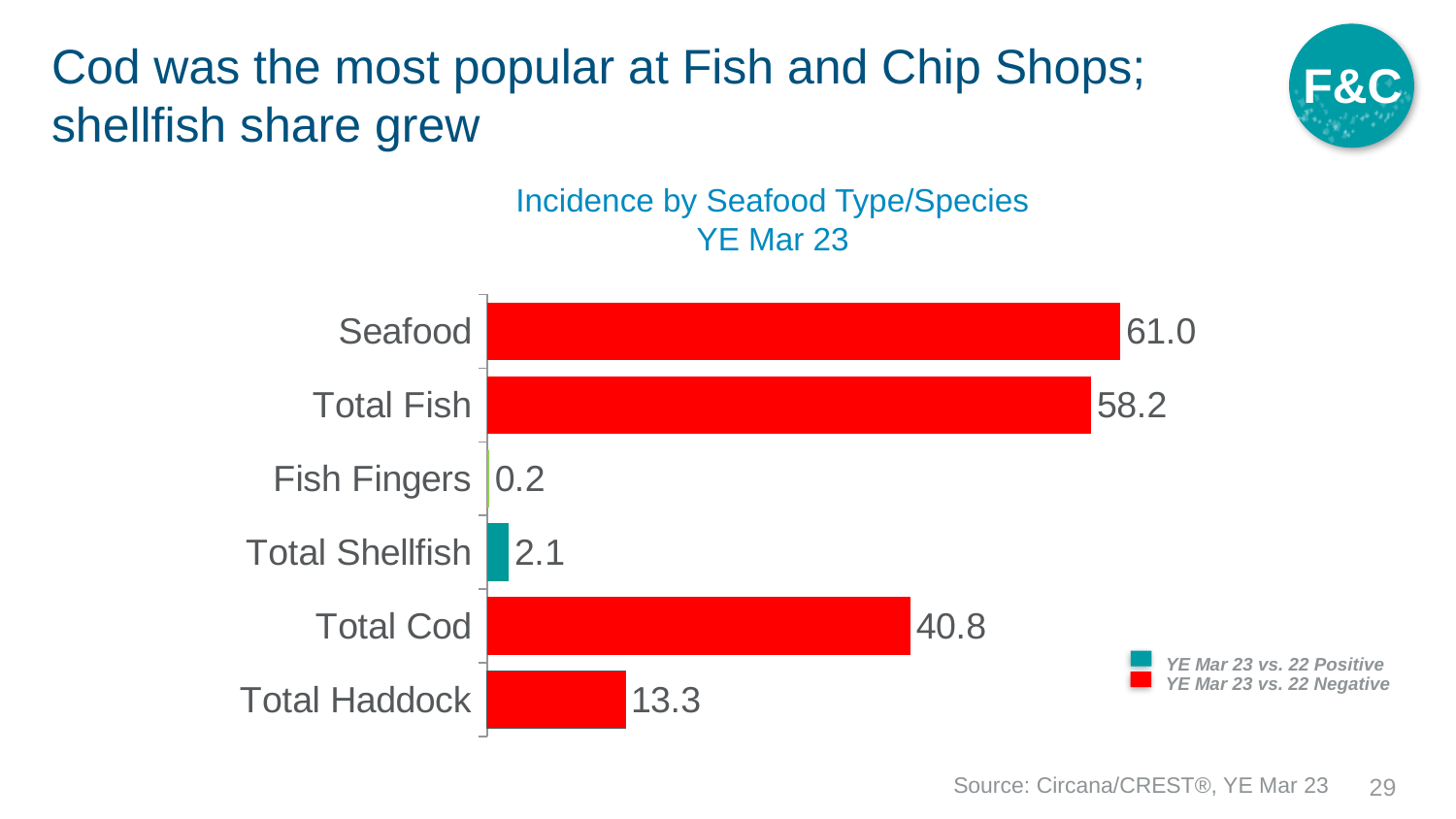
Which category has the highest value? Seafood What is the value for Total Cod? 40.8 What is the value for Seafood? 61.0 What is the difference between the values for Seafood and Total Fish? 2.8 How many categories are shown in the chart? 6 What kind of chart is shown on the slide? Bar chart What is the value for Total Shellfish? 2.1 What is the difference between the values for Total Cod and Total Haddock? 27.5 What is the value for Fish Fingers? 0.2 Which category is shown with a teal bar, indicating a positive change vs. YE Mar 22? Total Shellfish Which is larger, the value for Total Cod or the value for Total Haddock? Total Cod Which category has the lowest value? Fish Fingers